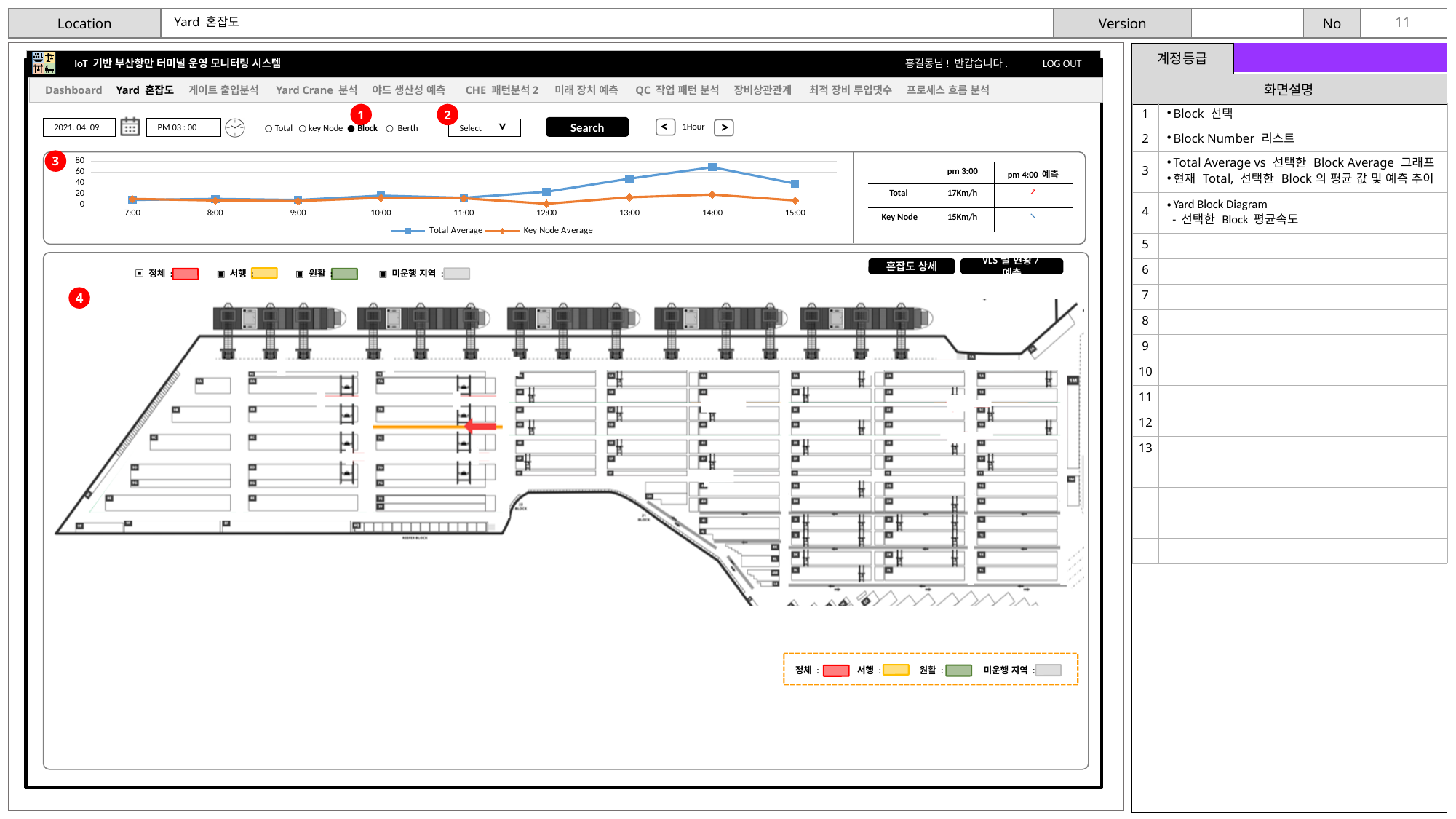
At 14:00, which series has the larger value, Total Average or Key Node Average? Total Average Does the Total Average series rise or fall between 12:00 and 14:00? rise What are the two series named in the line chart's legend? Total Average and Key Node Average Is the Total Average value at 14:00 greater or less than 60? greater Is the Total Average value at 7:00 greater or less than 20? less How many time points are plotted along the x axis of the line chart? 9 Is the Key Node Average value at 12:00 greater or less than 20? less How many series does the legend of the line chart list? 2 What kind of chart is shown at the top of the dashboard? line chart At which time does the Total Average series reach its highest value? 14:00 Which colour is used for the Total Average line in the chart? blue